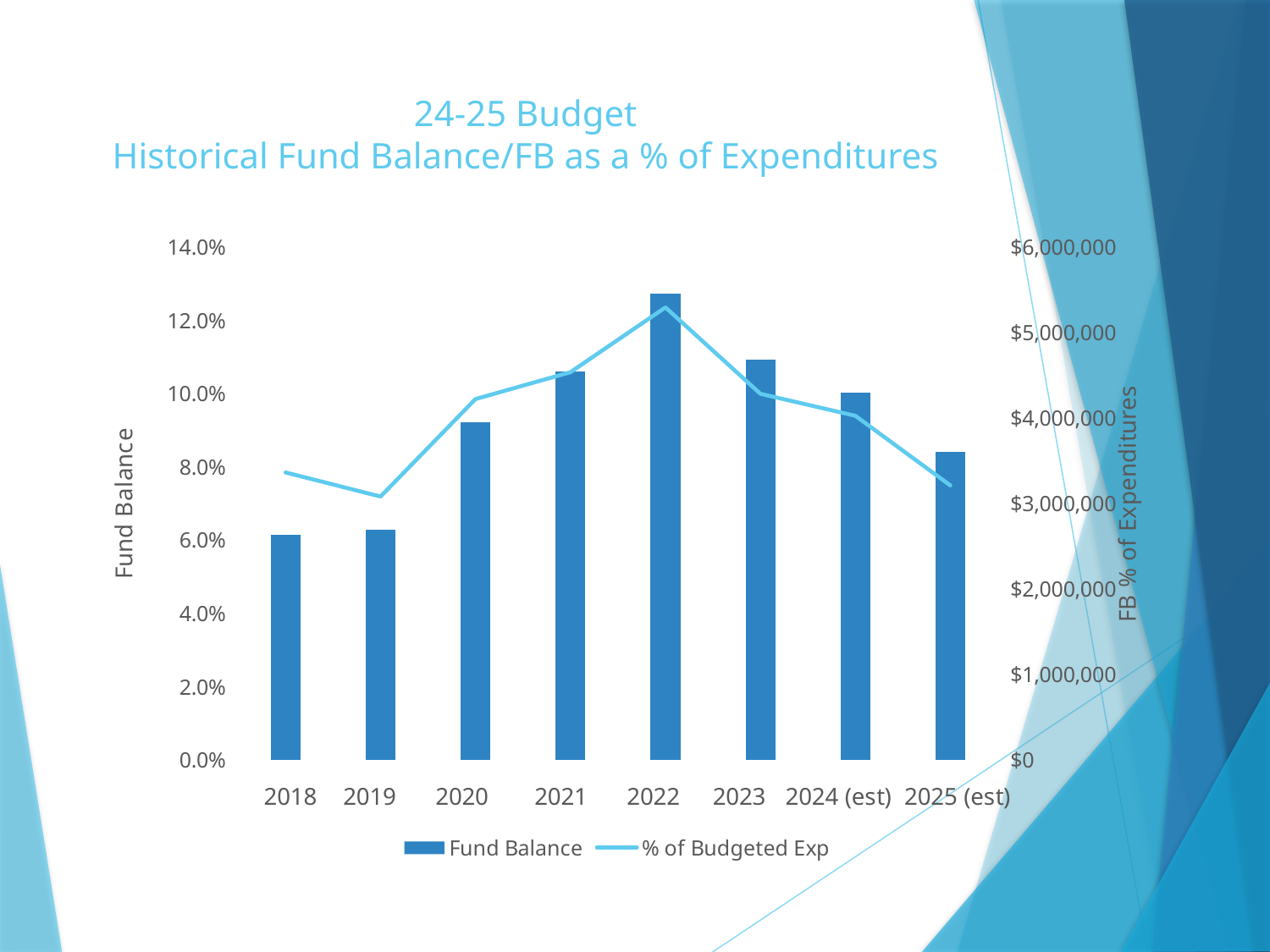
Do the Fund Balance bars rise or fall from 2019 to 2022? Rise Which year has the highest Fund Balance bar? 2022 What kind of chart is shown on the slide? A combination bar and line chart Which is larger, the Fund Balance bar for 2020 or for 2024 (est)? 2024 (est) In which year does the % of Budgeted Exp line reach its highest point? 2022 Does the % of Budgeted Exp line rise or fall from 2022 to 2025 (est)? Fall Is the % of Budgeted Exp line higher in 2019 or in 2020? 2020 Which is larger, the Fund Balance bar for 2018 or for 2025 (est)? 2025 (est) What is the title of the chart on the slide? 24-25 Budget Historical Fund Balance/FB as a % of Expenditures How many years are shown on the x axis of the chart? 8 How many series does the chart legend list? 2 What are the two series named in the chart legend? Fund Balance and % of Budgeted Exp